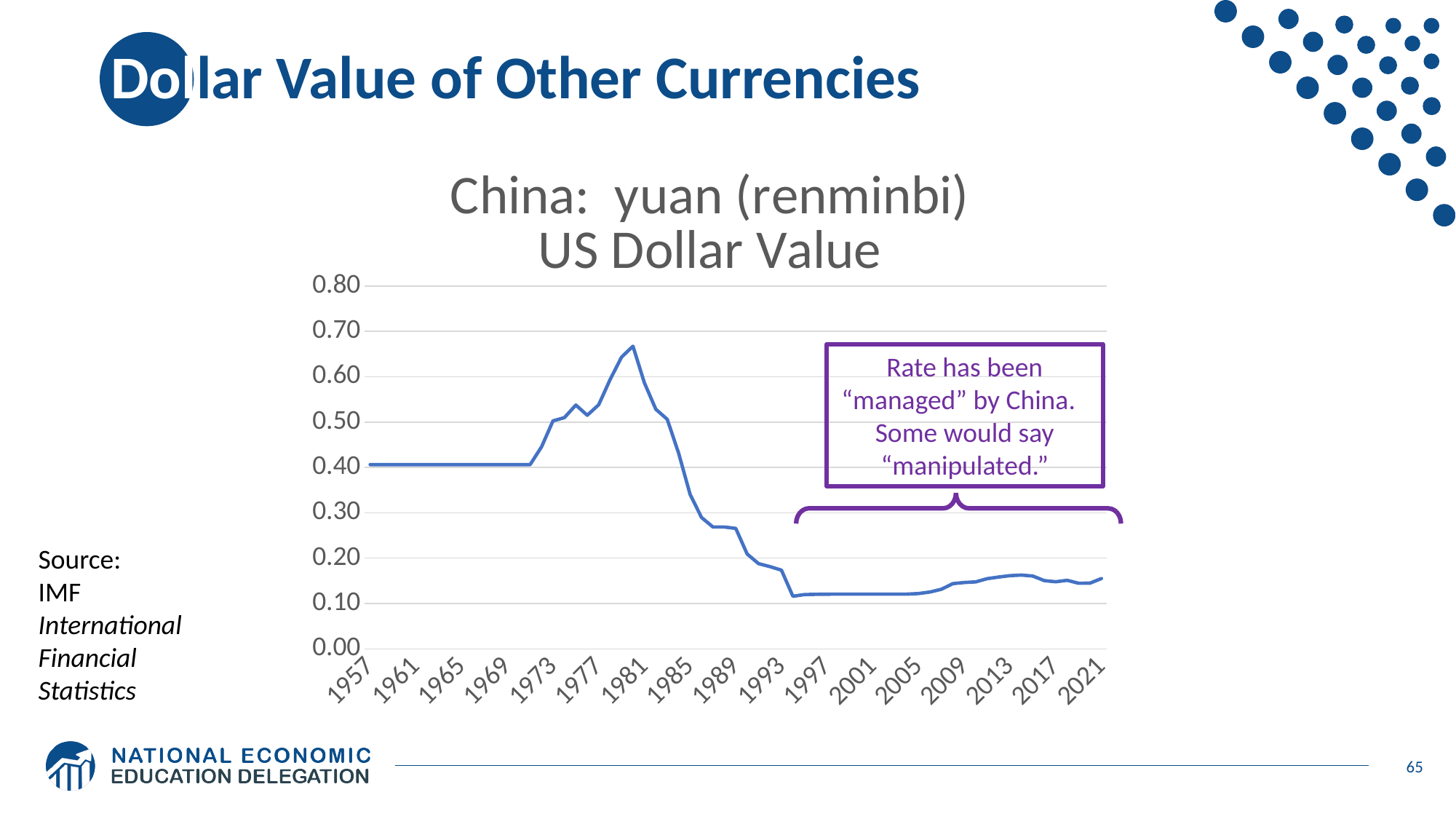
Is the value for 1957 greater or less than 0.30? greater What is the title of the chart? China: yuan (renminbi) US Dollar Value How many year labels are shown on the x axis? 17 Which year has the larger value, 1973 or 2013? 1973 Is the value for 1997 greater or less than 0.20? less Is the value for 2021 greater or less than 0.30? less What kind of chart is shown on the slide? line chart What is the highest value shown on the y axis? 0.80 In which year does the US dollar value of the yuan reach its highest point? 1980 Do the values rise or fall between 1981 and 1993? fall